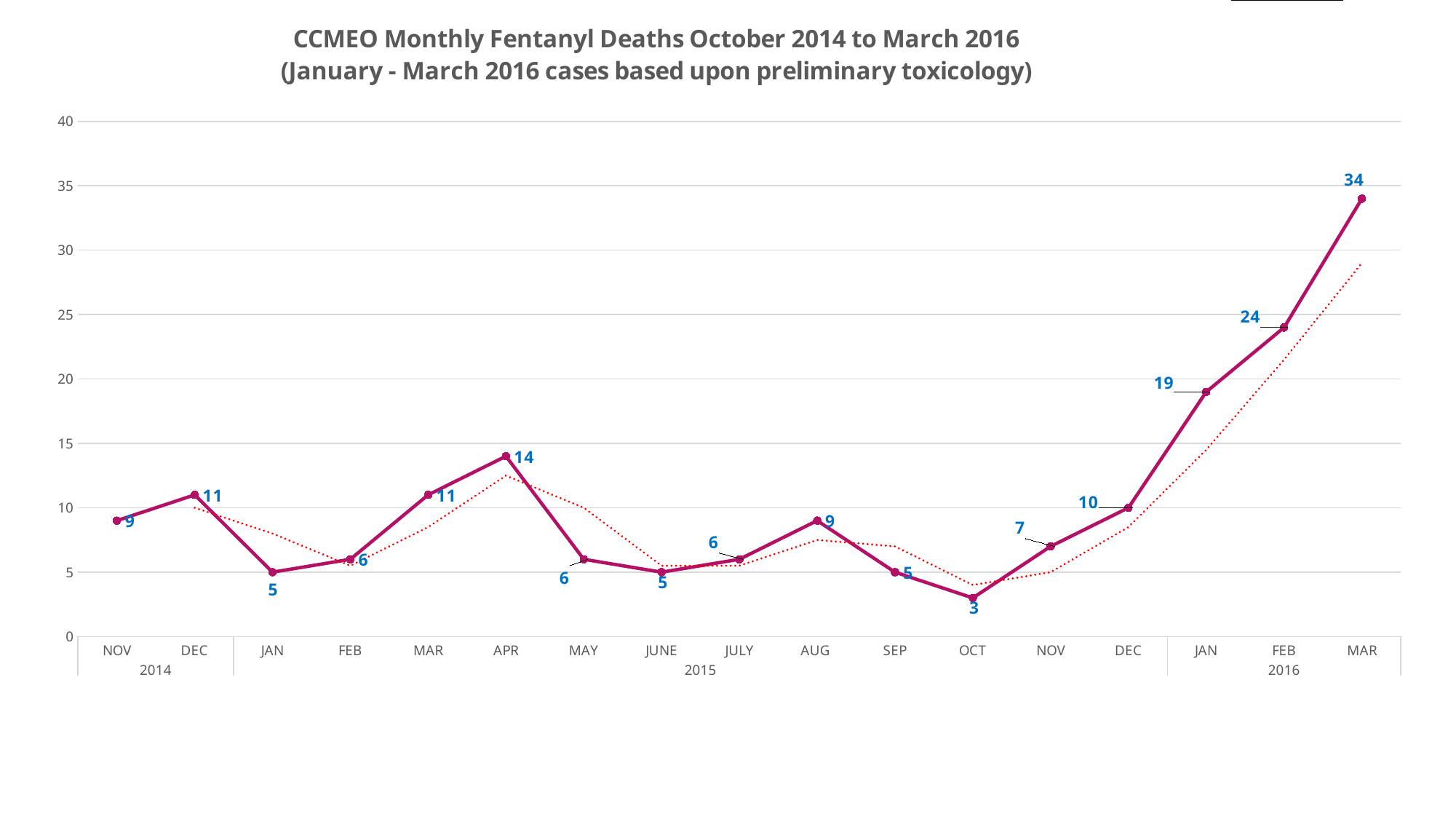
What is the difference in fentanyl deaths between March 2016 and February 2016? 10 Do the fentanyl deaths rise or fall from December 2015 to March 2016? rise How many fentanyl deaths are shown for October 2015? 3 How many fentanyl deaths are shown for April 2015? 14 Which month has more fentanyl deaths, December 2014 or March 2015? They are equal (11) What kind of chart is shown on the slide? line chart What is the difference in fentanyl deaths between January 2016 and December 2015? 9 Which month has the lowest number of fentanyl deaths? OCT 2015 How many monthly data points are plotted on the chart? 17 How many fentanyl deaths are shown for March 2016? 34 Which month has the highest number of fentanyl deaths? MAR 2016 How many fentanyl deaths are shown for November 2014? 9